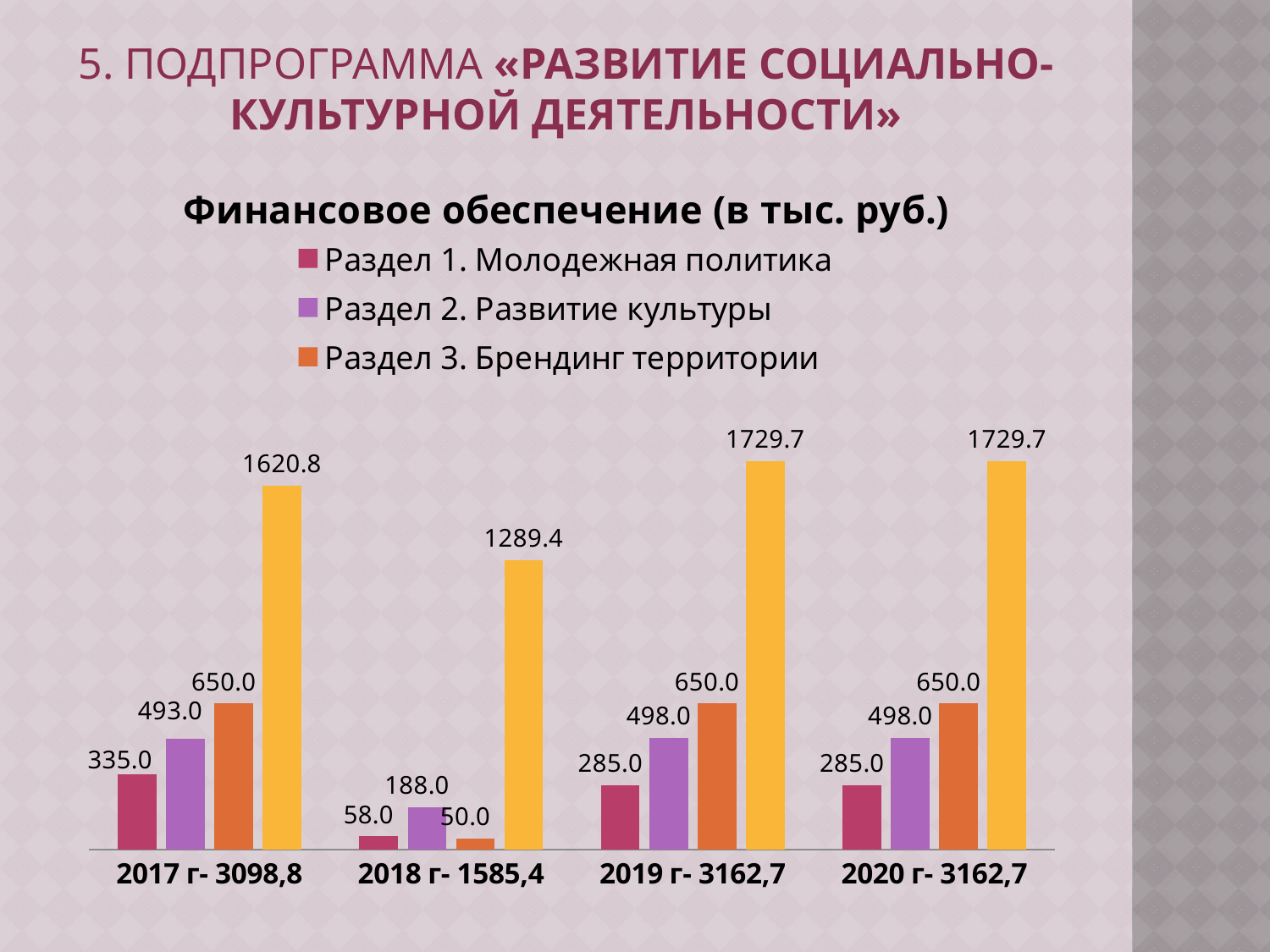
In which year category is the value for Раздел 3. Брендинг территории lowest? 2018 г- 1585,4 In which year category is the value for Раздел 1. Молодежная политика highest? 2017 г- 3098,8 What kind of chart is shown on the slide? bar chart Which is larger in 2018 г- 1585,4: Раздел 1. Молодежная политика or Раздел 3. Брендинг территории? Раздел 1. Молодежная политика What is the value for Раздел 1. Молодежная политика in 2017 г- 3098,8? 335.0 What is the difference between the Раздел 3. Брендинг территории and Раздел 1. Молодежная политика values in 2017 г- 3098,8? 315.0 How many year categories are shown on the x axis? 4 What is the value for Раздел 1. Молодежная политика in 2020 г- 3162,7? 285.0 What is the value for Раздел 3. Брендинг территории in 2019 г- 3162,7? 650.0 How many series does the legend list? 3 What is the value for Раздел 2. Развитие культуры in 2018 г- 1585,4? 188.0 What is the difference between the Раздел 2. Развитие культуры values for 2019 г- 3162,7 and 2017 г- 3098,8? 5.0